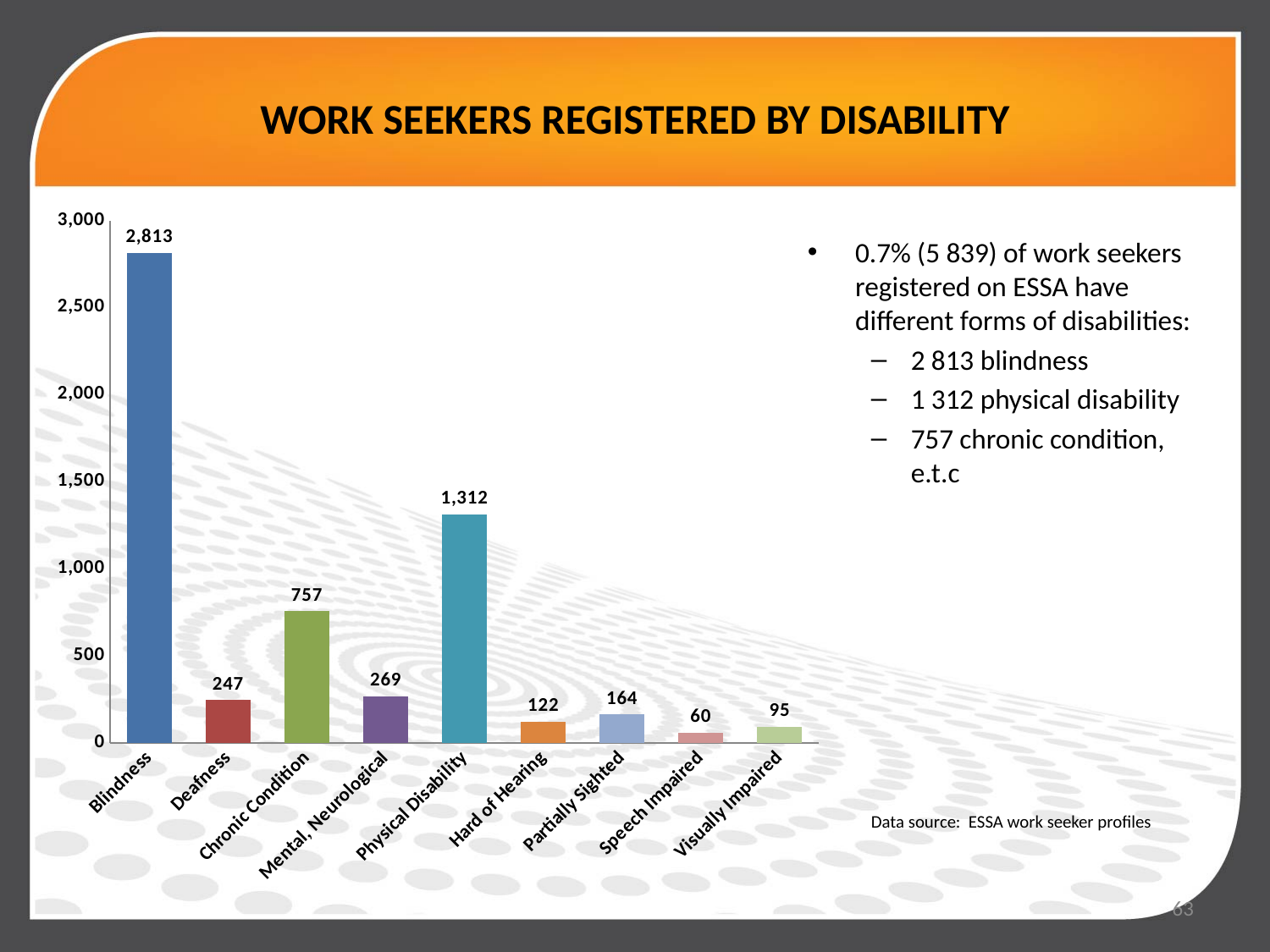
What is the difference between the values for Blindness and Physical Disability? 1,501 How many categories are shown on the x axis? 9 What kind of chart is shown on the slide? bar chart Which category has the highest value? Blindness What is the value for Physical Disability? 1,312 What is the value for Blindness? 2,813 Which is larger, the value for Deafness or the value for Mental, Neurological? Mental, Neurological What is the title of the chart? WORK SEEKERS REGISTERED BY DISABILITY What is the value for Hard of Hearing? 122 What is the difference between the values for Partially Sighted and Visually Impaired? 69 Which category has the lowest value? Speech Impaired Is the value for Chronic Condition greater or less than 500? greater